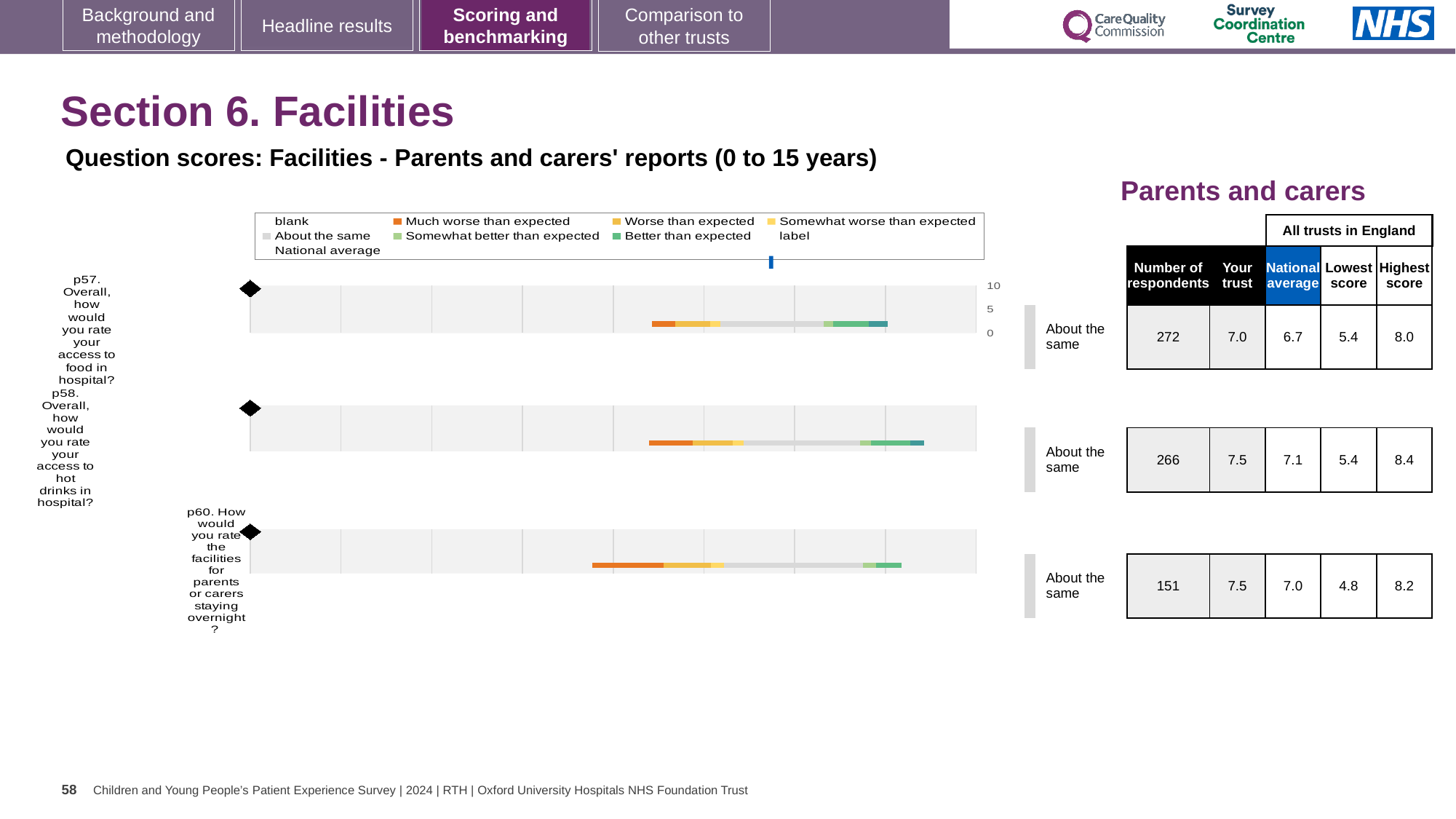
What is the 'Your trust' score for p57 (access to food in hospital)? 7.0 What benchmark category is shown for p57? About the same What is the national average score for p58 (access to hot drinks in hospital)? 7.1 For p57, which is larger: the 'Your trust' score or the national average? Your trust What kind of chart is used to show the question scores for Facilities? Bar chart What is the difference between the highest score and the lowest score for p60? 3.4 How many questions are plotted in the Facilities chart? 3 Which question has the lowest 'Your trust' score? p57 What is the lowest score across all trusts in England for p58? 5.4 Which question has the fewest respondents? p60 How many respondents answered p60 (facilities for parents or carers staying overnight)? 151 What is the difference between the 'Your trust' score and the national average for p58? 0.4